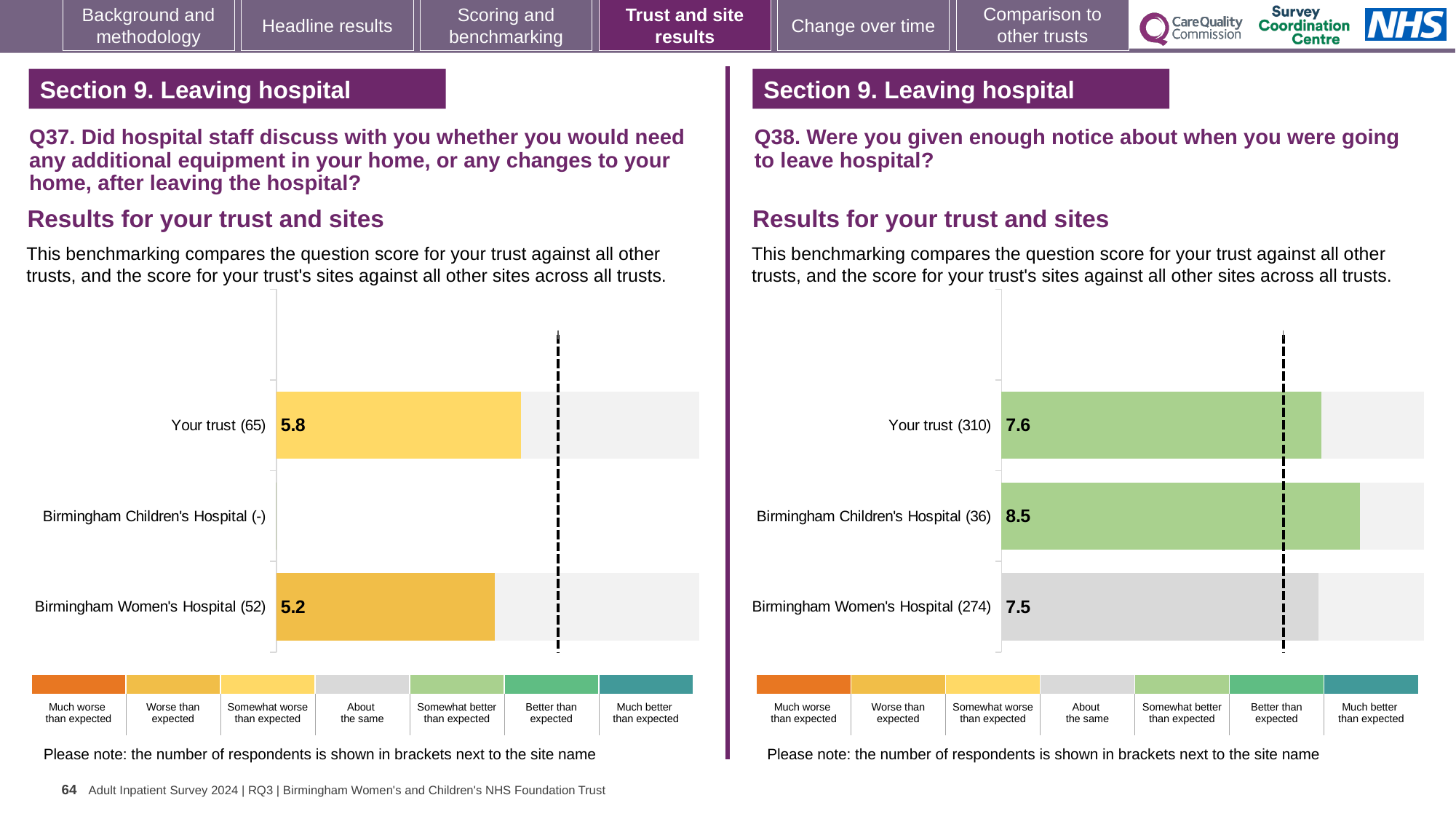
In the Q37 chart on the left, what is the difference between the scores for Your trust and Birmingham Women's Hospital? 0.6 In the Q37 chart on the left, which category has no bar plotted? Birmingham Children's Hospital In the Q38 chart on the right, which is larger, the score for Birmingham Children's Hospital or for Birmingham Women's Hospital? Birmingham Children's Hospital In the Q38 chart on the right, how many respondents are shown in brackets for Your trust? 310 What kind of chart is used for the Q37 results on the left? Bar chart In the Q37 chart on the left, what is the score for Birmingham Women's Hospital? 5.2 In the Q38 chart on the right, what is the difference between the scores for Birmingham Children's Hospital and Your trust? 0.9 In the Q37 chart on the left, what is the score for Your trust? 5.8 In the Q38 chart on the right, what is the score for Birmingham Children's Hospital? 8.5 In the Q37 chart on the left, which is larger, the score for Your trust or for Birmingham Women's Hospital? Your trust In the Q38 chart on the right, which category has the highest score? Birmingham Children's Hospital In the Q38 chart on the right, what is the score for Birmingham Women's Hospital? 7.5